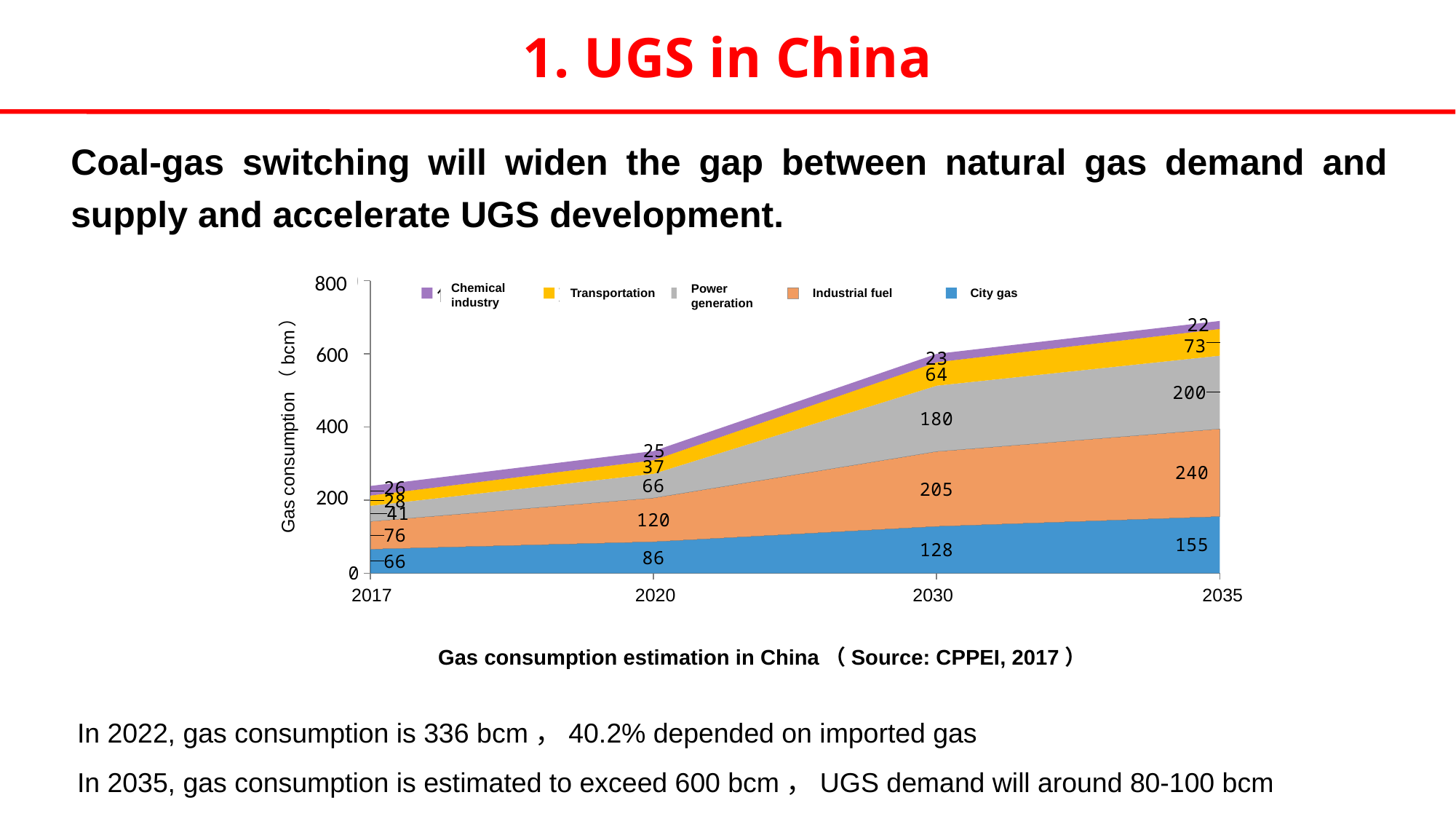
What is the Power generation value for 2030? 180 What is the City gas value for 2035? 155 Which is larger in 2030, Industrial fuel or Power generation? Industrial fuel How many series does the legend list? 5 In which year is the Industrial fuel value highest? 2035 In which year is the Chemical industry value lowest? 2035 How many years are shown on the x axis? 4 What is the Transportation value for 2017? 28 What is the difference between the City gas values for 2035 and 2017? 89 What is the total gas consumption across all five sectors in 2030? 600 What kind of chart is shown? Stacked area chart What is the Industrial fuel value for 2020? 120